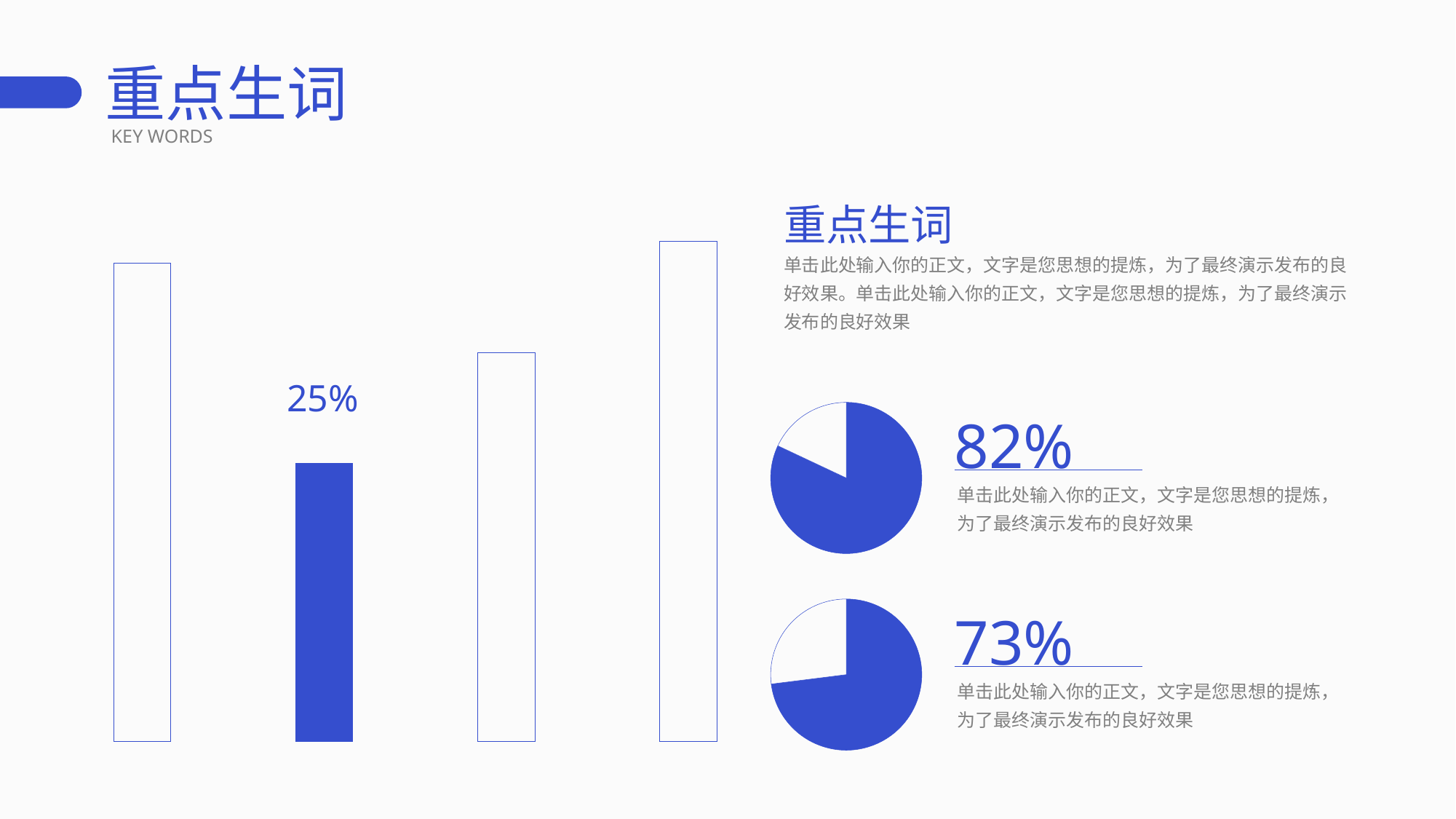
What value is shown next to the upper pie chart on the right? 82% In the bar chart on the left, which bar is the tallest? the fourth (rightmost) bar What kind of chart is shown on the left side of the slide? bar chart How many bars does the bar chart on the left side of the slide have? 4 In the bar chart on the left, which bar is the shortest? the second bar In the bar chart on the left, which bar is the only one filled with solid blue? the second bar How many pie charts are on the slide? 2 In the bar chart on the left, what value is printed above the filled (solid blue) bar? 25% What is the difference between the values of the upper pie chart (82%) and the lower pie chart (73%)? 9% What kind of charts are shown on the right side of the slide next to the 82% and 73% labels? pie charts Which pie chart on the right shows the larger value, the upper one or the lower one? the upper one What value is shown next to the lower pie chart on the right? 73%